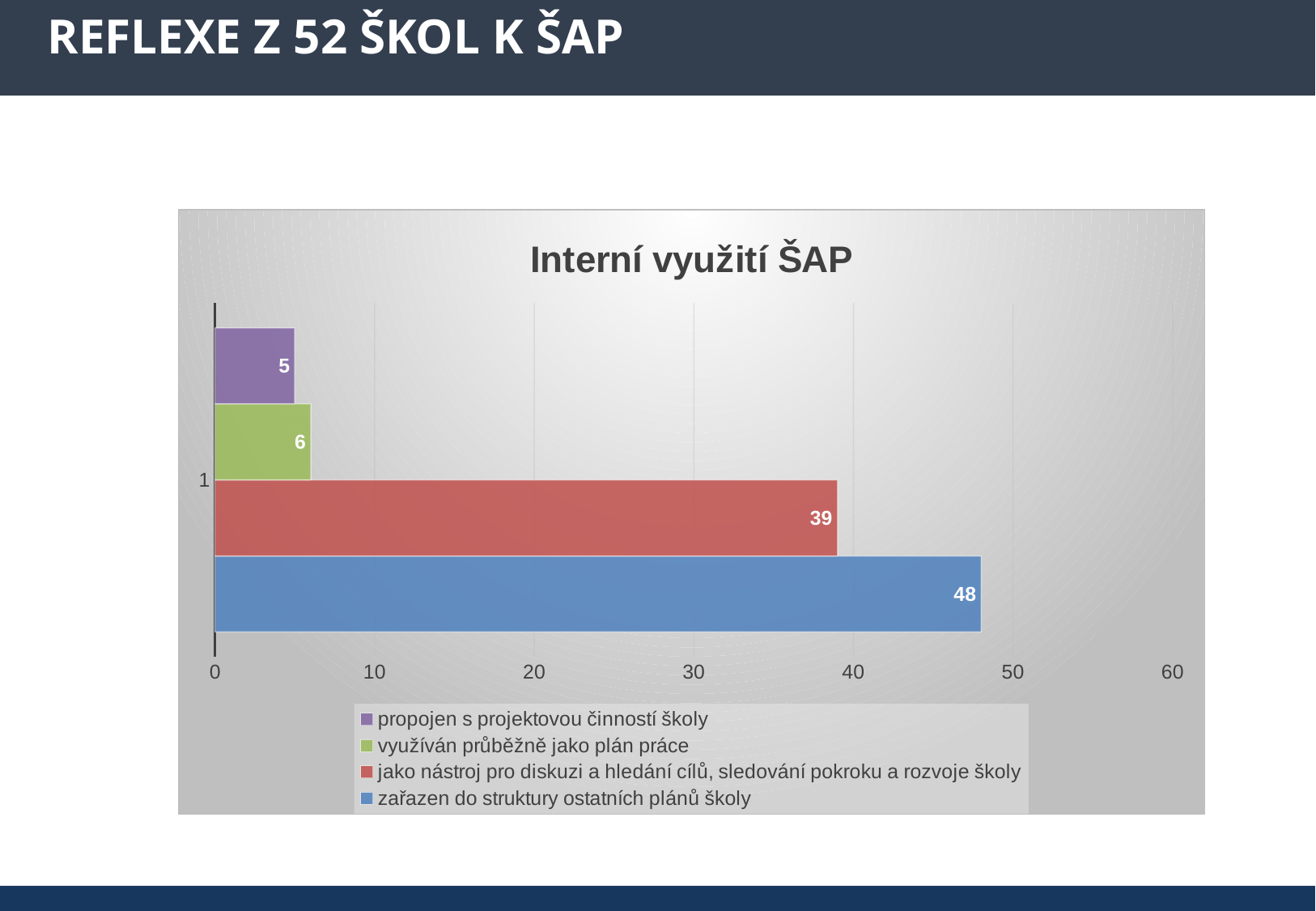
How many series does the legend list? 4 What is the value for "zařazen do struktury ostatních plánů školy"? 48 What is the title of the chart? Interní využití ŠAP Which is larger: the value for "využíván průběžně jako plán práce" or for "propojen s projektovou činností školy"? využíván průběžně jako plán práce Is the value for "jako nástroj pro diskuzi a hledání cílů, sledování pokroku a rozvoje školy" greater or less than 40? less What is the value for "využíván průběžně jako plán práce"? 6 Which series has the lowest value? propojen s projektovou činností školy What kind of chart is shown? bar chart Which series has the highest value? zařazen do struktury ostatních plánů školy What is the difference between the values for "zařazen do struktury ostatních plánů školy" and "jako nástroj pro diskuzi a hledání cílů, sledování pokroku a rozvoje školy"? 9 What is the value for "jako nástroj pro diskuzi a hledání cílů, sledování pokroku a rozvoje školy"? 39 What is the value for "propojen s projektovou činností školy"? 5